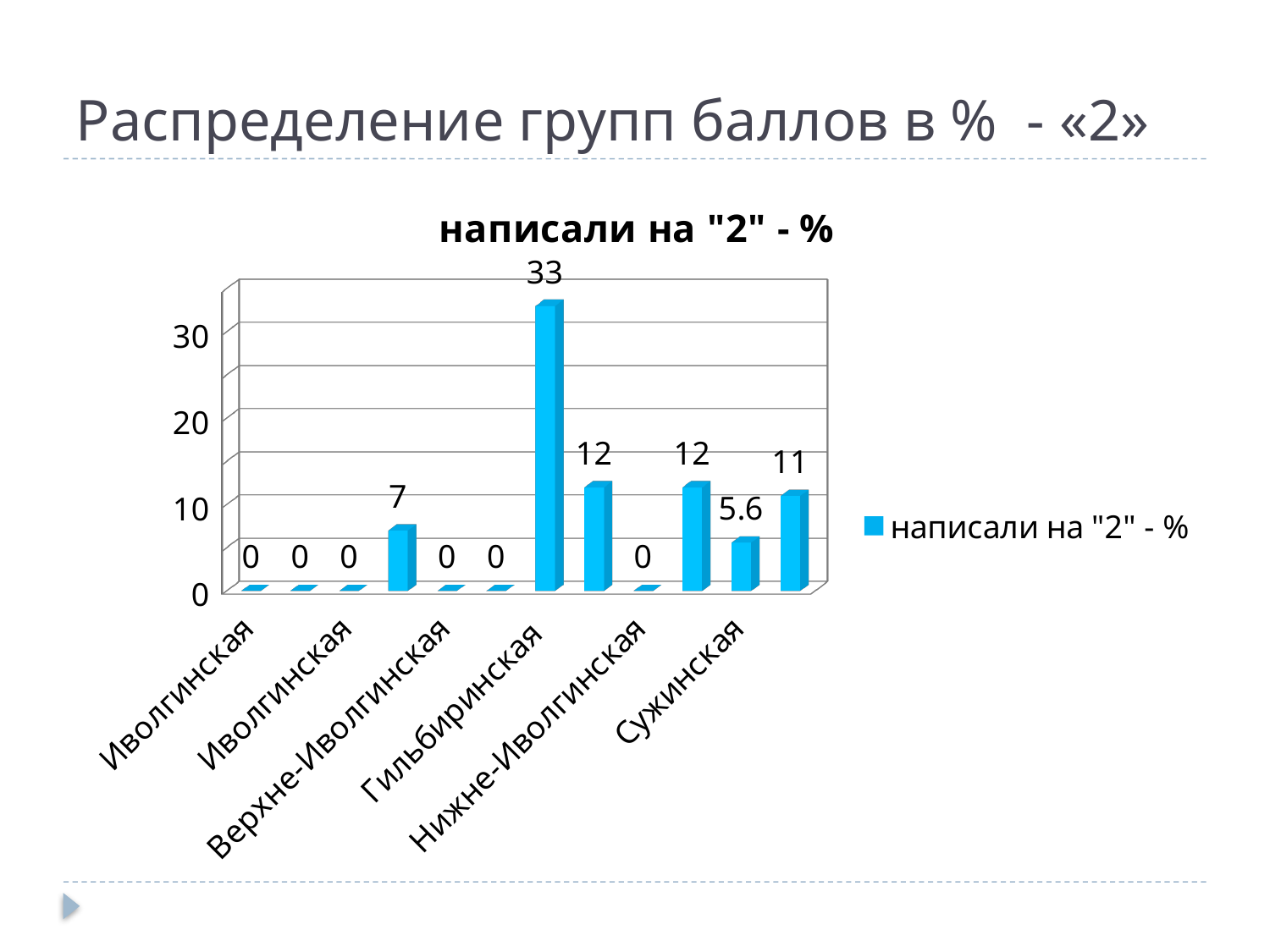
How many bars are plotted in the chart? 12 Is the value for Гильбиринская greater or less than 30? greater What is the highest value shown in the chart? 33 What is the title of the chart? написали на "2" - % Which is larger, the value for Гильбиринская or the value labelled 5.6? Гильбиринская How many series does the legend list? 1 What is the difference between the highest value (33) and the value 12 shown next to it? 21 What is the lowest value shown in the chart? 0 What kind of chart is shown on the slide? bar chart What is the smallest non-zero value labelled in the chart? 5.6 How many bars have a value of 0? 6 What is the value for Гильбиринская? 33